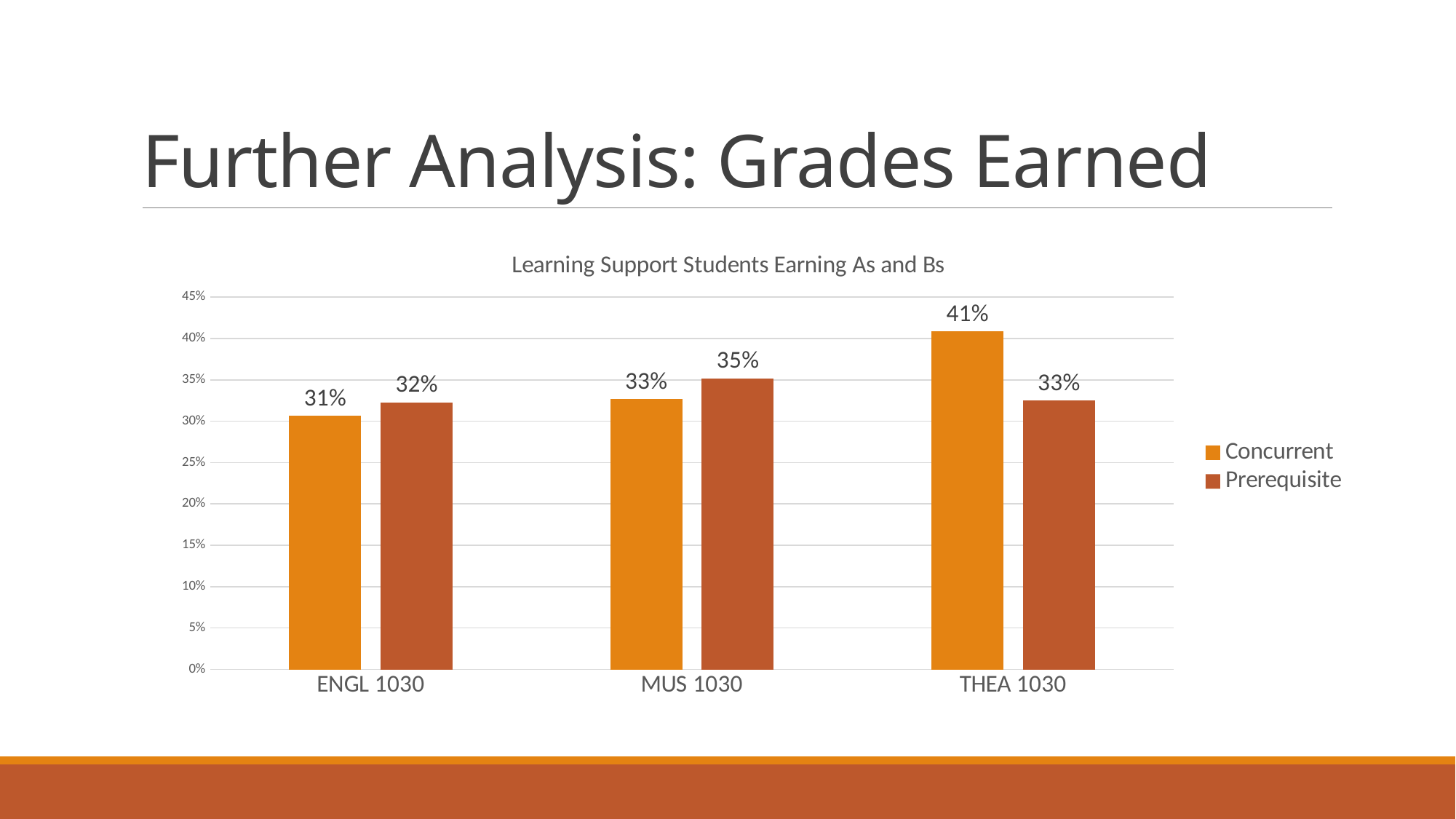
For MUS 1030, which is larger: the Concurrent value or the Prerequisite value? Prerequisite Which course has the lowest Prerequisite value? ENGL 1030 What is the Prerequisite value for MUS 1030? 35% What is the difference between the Concurrent and Prerequisite values for THEA 1030? 8% What is the title of the chart? Learning Support Students Earning As and Bs What is the Concurrent value for ENGL 1030? 31% Which course has the highest Concurrent value? THEA 1030 What is the Prerequisite value for THEA 1030? 33% How many courses are shown on the x axis? 3 What is the Concurrent value for THEA 1030? 41% Is the Concurrent value for THEA 1030 greater or less than 40%? greater How many series does the legend list? 2